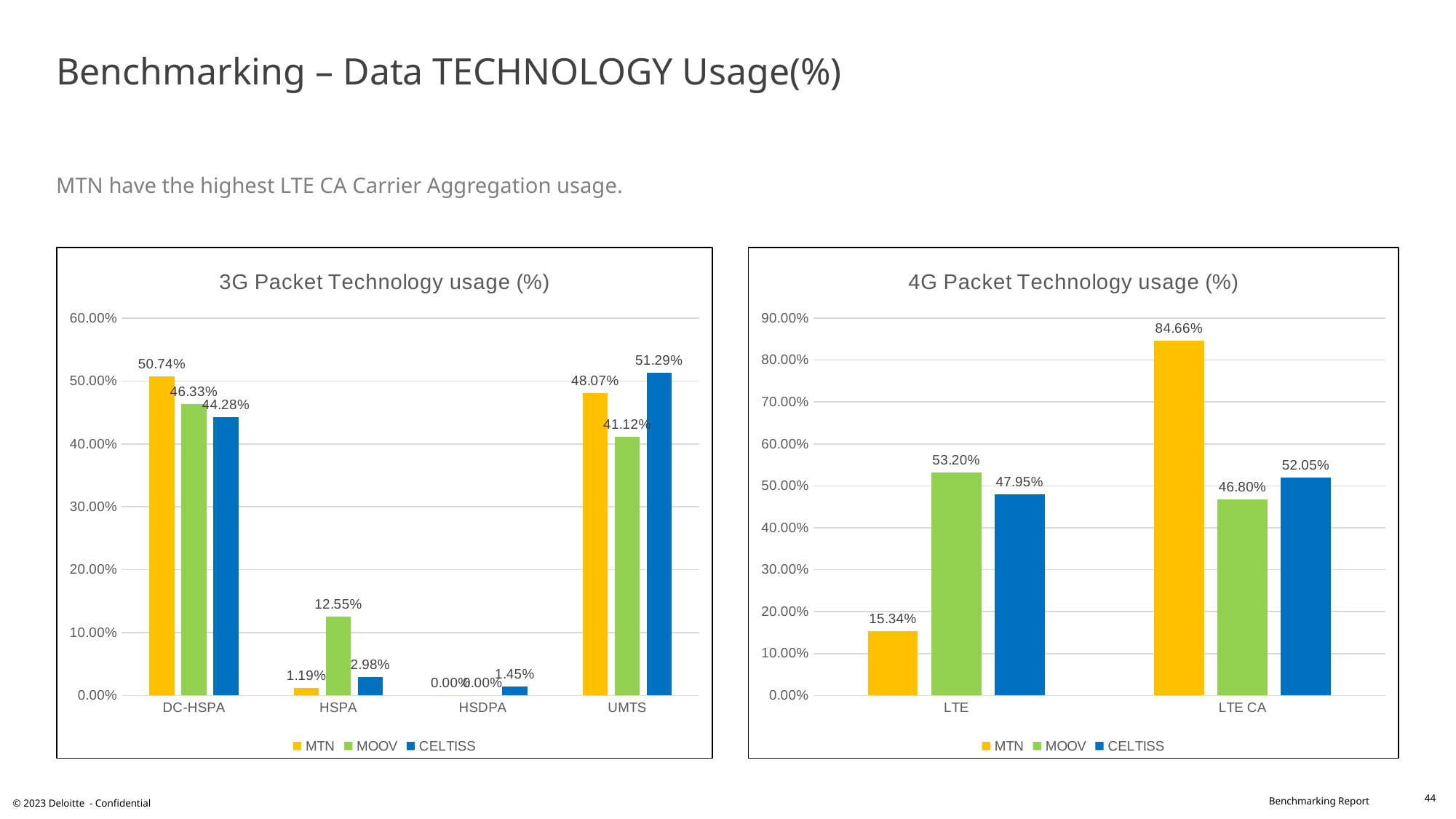
In the 3G Packet Technology usage chart, which operator has the highest value at UMTS? CELTISS How many series does the legend of the 4G Packet Technology usage chart list? 3 In the 3G Packet Technology usage chart, what is the value for MOOV at HSPA? 12.55% In the 3G Packet Technology usage chart, what is the value for MTN at DC-HSPA? 50.74% In the 4G Packet Technology usage chart, what is the difference between MTN and MOOV at LTE CA? 37.86% In the 3G Packet Technology usage chart, what is the value for CELTISS at HSDPA? 1.45% In the 4G Packet Technology usage chart, which operator has the lowest value at LTE? MTN In the 3G Packet Technology usage chart, how many technology categories are shown on the x axis? 4 What type of chart is the 3G Packet Technology usage chart? Bar chart In the 4G Packet Technology usage chart, which is larger at LTE: MOOV or CELTISS? MOOV In the 3G Packet Technology usage chart, what is the difference between MTN and CELTISS at DC-HSPA? 6.46% In the 4G Packet Technology usage chart, what is the value for MTN at LTE CA? 84.66%